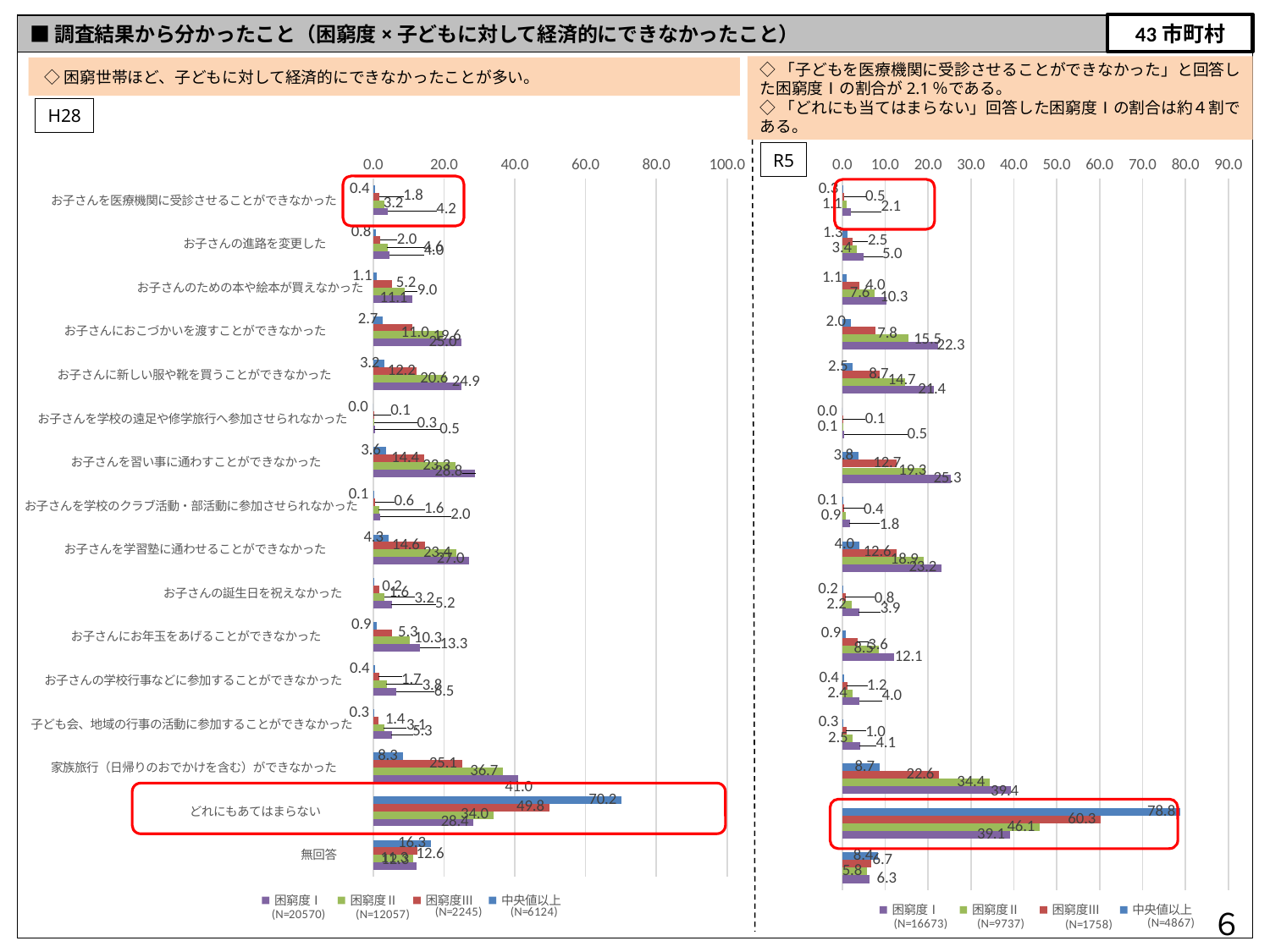
What kind of chart is the R5 chart? Bar chart In the H28 chart, what is the value for 困窮度Ⅰ in the どれにもあてはまらない category? 28.4 How many categories are plotted on the y axis of the H28 chart? 16 In the H28 chart, what is the value for 困窮度Ⅰ in the 家族旅行（日帰りのおでかけを含む）ができなかった category? 41.0 In the H28 chart, for 家族旅行（日帰りのおでかけを含む）ができなかった, which is larger: 困窮度Ⅰ or 困窮度Ⅲ? 困窮度Ⅰ In the H28 chart, which series has the highest value for どれにもあてはまらない? 中央値以上 In the R5 chart, what is the difference between the 中央値以上 and 困窮度Ⅰ values for どれにもあてはまらない? 39.7 How many series does the legend of the H28 chart list? 4 In the R5 chart, what is the value for 中央値以上 in the どれにもあてはまらない category? 78.8 In the R5 chart, is the 困窮度Ⅲ value for どれにもあてはまらない greater or less than 50.0? greater In the R5 chart, what is the value for 困窮度Ⅰ in the お子さんを医療機関に受診させることができなかった category? 2.1 In the H28 chart, what is the difference between the 困窮度Ⅰ and 中央値以上 values for お子さんを医療機関に受診させることができなかった? 3.8